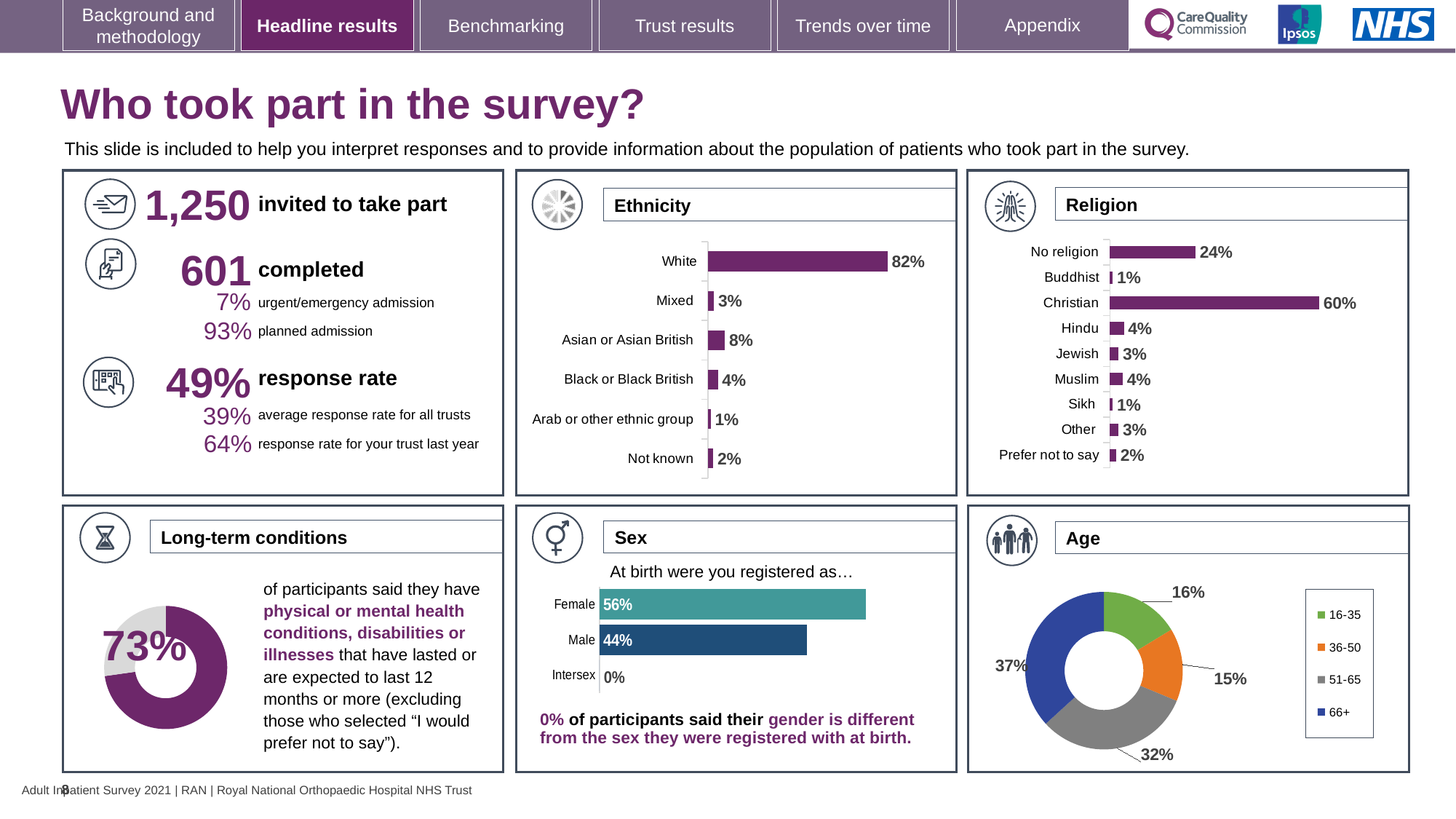
In the Ethnicity chart, which ethnic group has the lowest percentage? Arab or other ethnic group In the Sex chart, what percentage of participants were registered as Male at birth? 44% In the Ethnicity chart, how many categories are shown? 6 In the Religion chart, what is the difference between the Christian and No religion percentages? 36% In the Religion chart, which is larger, the value for Hindu or the value for Jewish? Hindu In the Ethnicity chart, what percentage of participants were White? 82% In the Religion chart, how many religion categories are listed? 9 In the Age chart, how many age groups does the legend list? 4 In the Sex chart, what is the difference between the Female and Male percentages? 12% In the Religion chart, what percentage of participants were Christian? 60% In the Age chart, which age group has the largest share? 66+ What type of chart is used for the Age breakdown? Doughnut chart